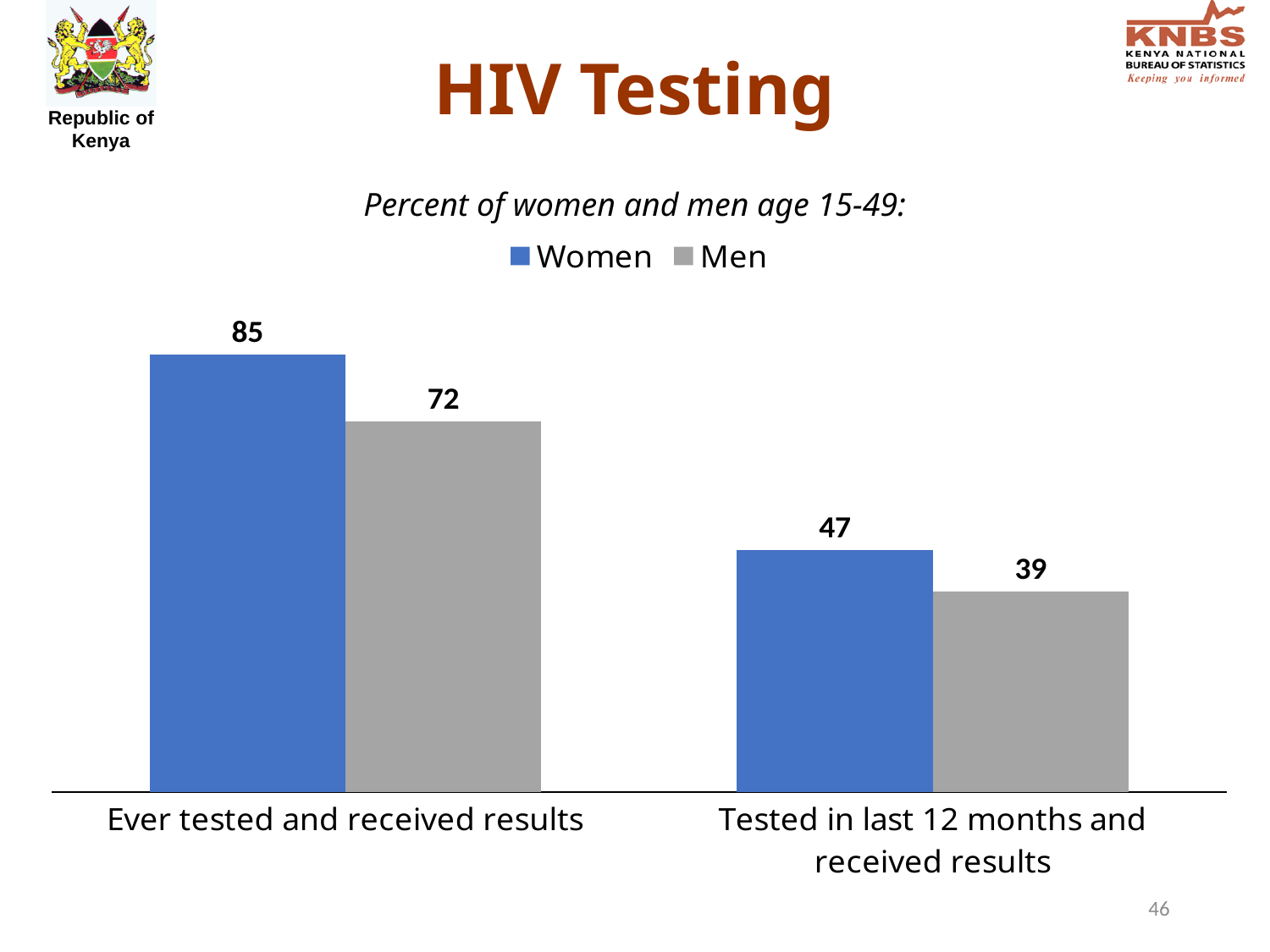
What is the value for Men for 'Ever tested and received results'? 72 Which category has the highest value for Women? Ever tested and received results What is the value for Women for 'Ever tested and received results'? 85 What is the value for Men for 'Tested in last 12 months and received results'? 39 What kind of chart is shown on the slide? Bar chart Which is larger for 'Tested in last 12 months and received results': Women or Men? Women Which category has the lowest value for Men? Tested in last 12 months and received results How many series does the legend list? 2 What is the difference between the Women and Men values for 'Ever tested and received results'? 13 What is the difference between the Women and Men values for 'Tested in last 12 months and received results'? 8 What is the value for Women for 'Tested in last 12 months and received results'? 47 How many categories are shown on the x axis? 2